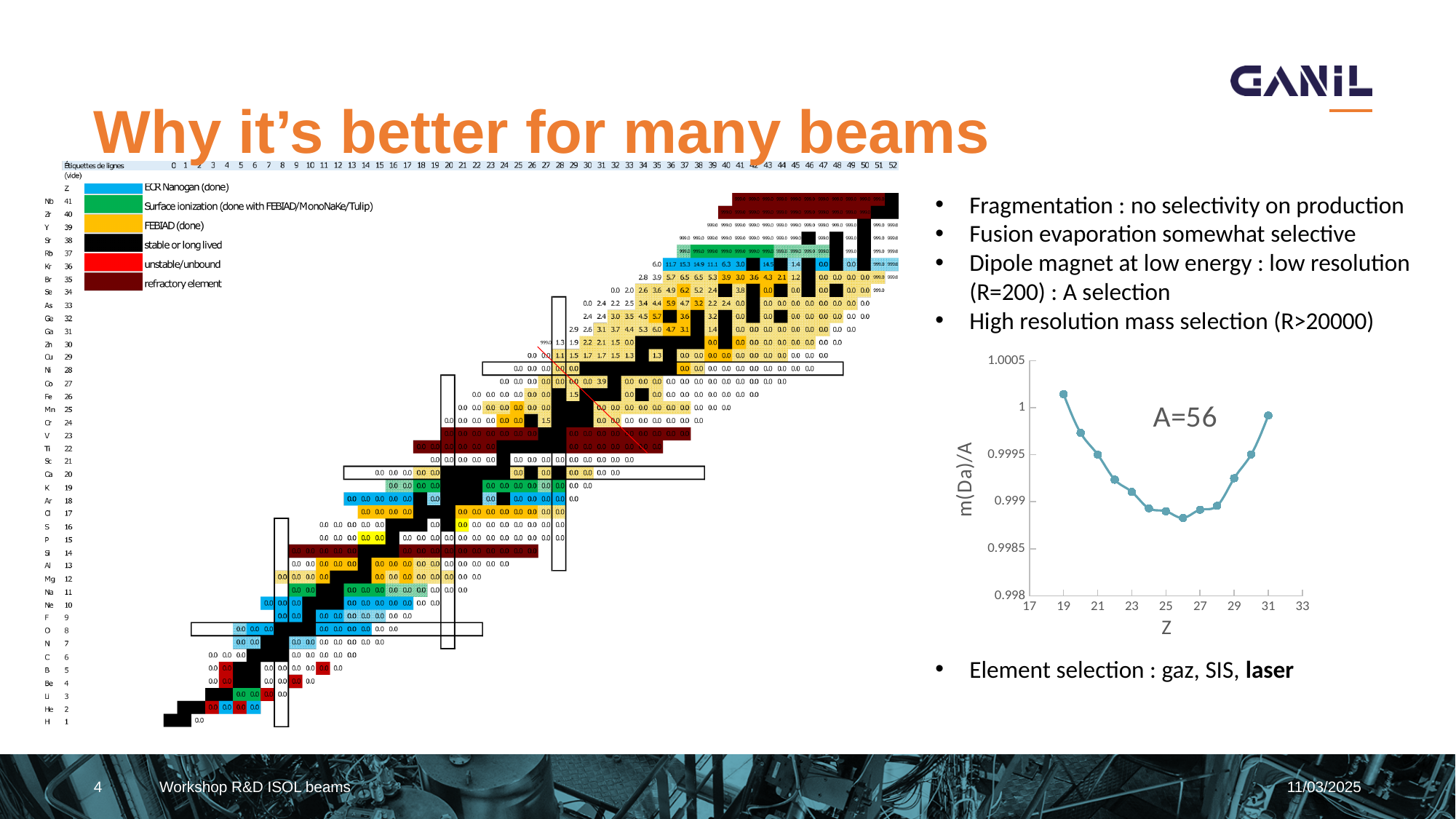
In the m(Da)/A versus Z chart, at which value of Z is m(Da)/A highest? 19 In the m(Da)/A versus Z chart, how does m(Da)/A change as Z increases from 19 to 26? it falls In the m(Da)/A versus Z chart, how many data points are plotted? 13 How many entries does the legend of the nuclide chart on the left of the slide list? 6 In the m(Da)/A versus Z chart, at which value of Z is m(Da)/A lowest? 26 In the m(Da)/A versus Z chart, which has the larger m(Da)/A value, Z=20 or Z=30? Z=20 In the m(Da)/A versus Z chart, is the value at Z=26 greater or less than 0.999? less What mass number A is annotated on the m(Da)/A versus Z chart? A=56 In the m(Da)/A versus Z chart, is the value at Z=22 greater or less than 0.9995? less What kind of chart is the m(Da)/A versus Z chart on the right of the slide? line chart In the m(Da)/A versus Z chart, is the value at Z=31 greater or less than 1? less